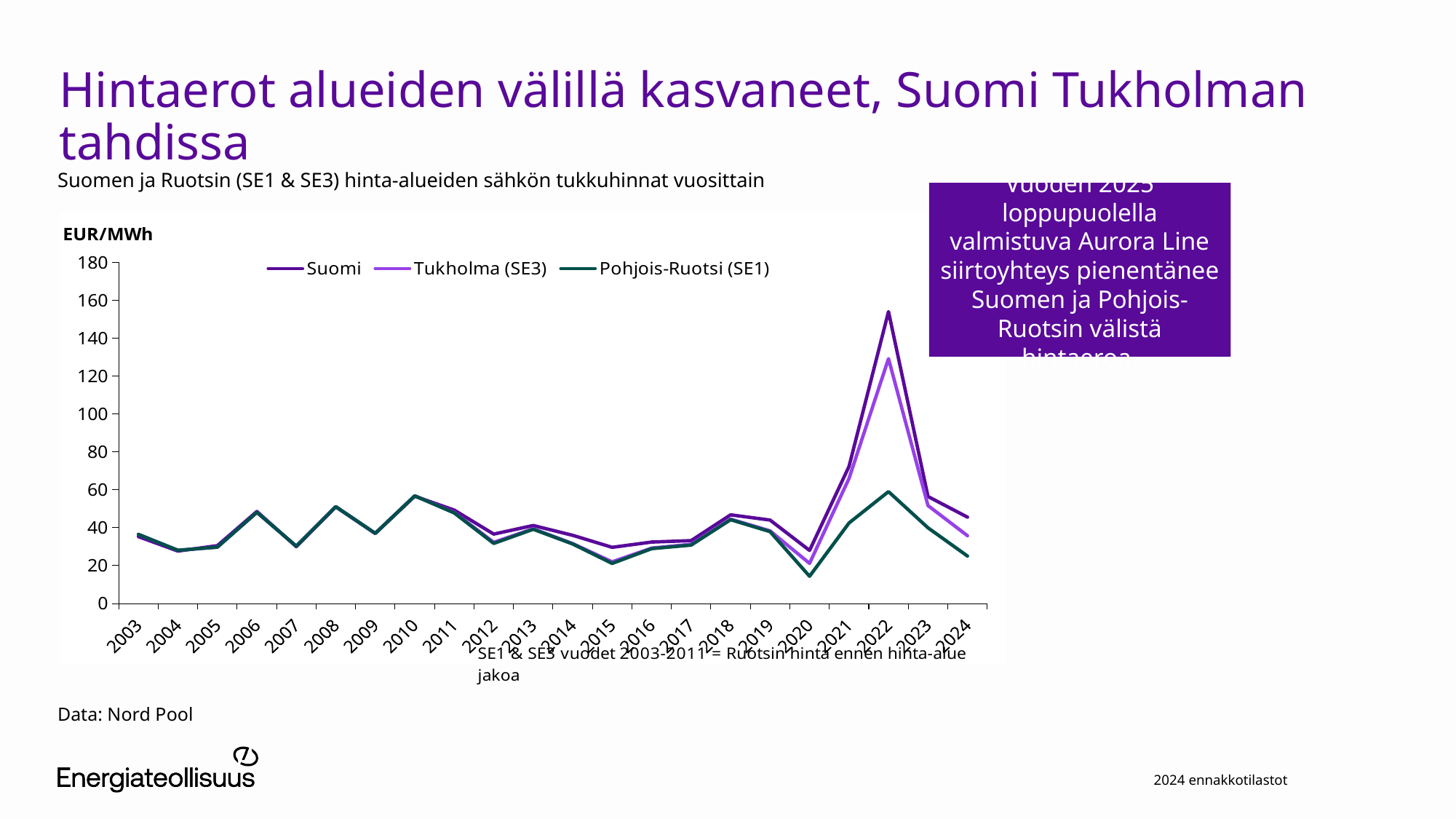
In which year does the Suomi series reach its highest value? 2022 Is the value for Suomi in 2022 greater or less than 140? greater How many series does the chart legend list? 3 How many years are plotted along the x axis? 22 Does the Suomi series rise or fall from 2022 to 2024? fall Which series are listed in the chart legend? Suomi, Tukholma (SE3), Pohjois-Ruotsi (SE1) In 2022, which is larger: the value for Suomi or the value for Pohjois-Ruotsi (SE1)? Suomi What kind of chart is shown on the slide? line chart In which year does the Pohjois-Ruotsi (SE1) series reach its lowest value? 2020 Is the value for Tukholma (SE3) in 2022 greater or less than 120? greater What unit is shown on the chart's vertical axis? EUR/MWh Is the value for Pohjois-Ruotsi (SE1) in 2020 greater or less than 20? less